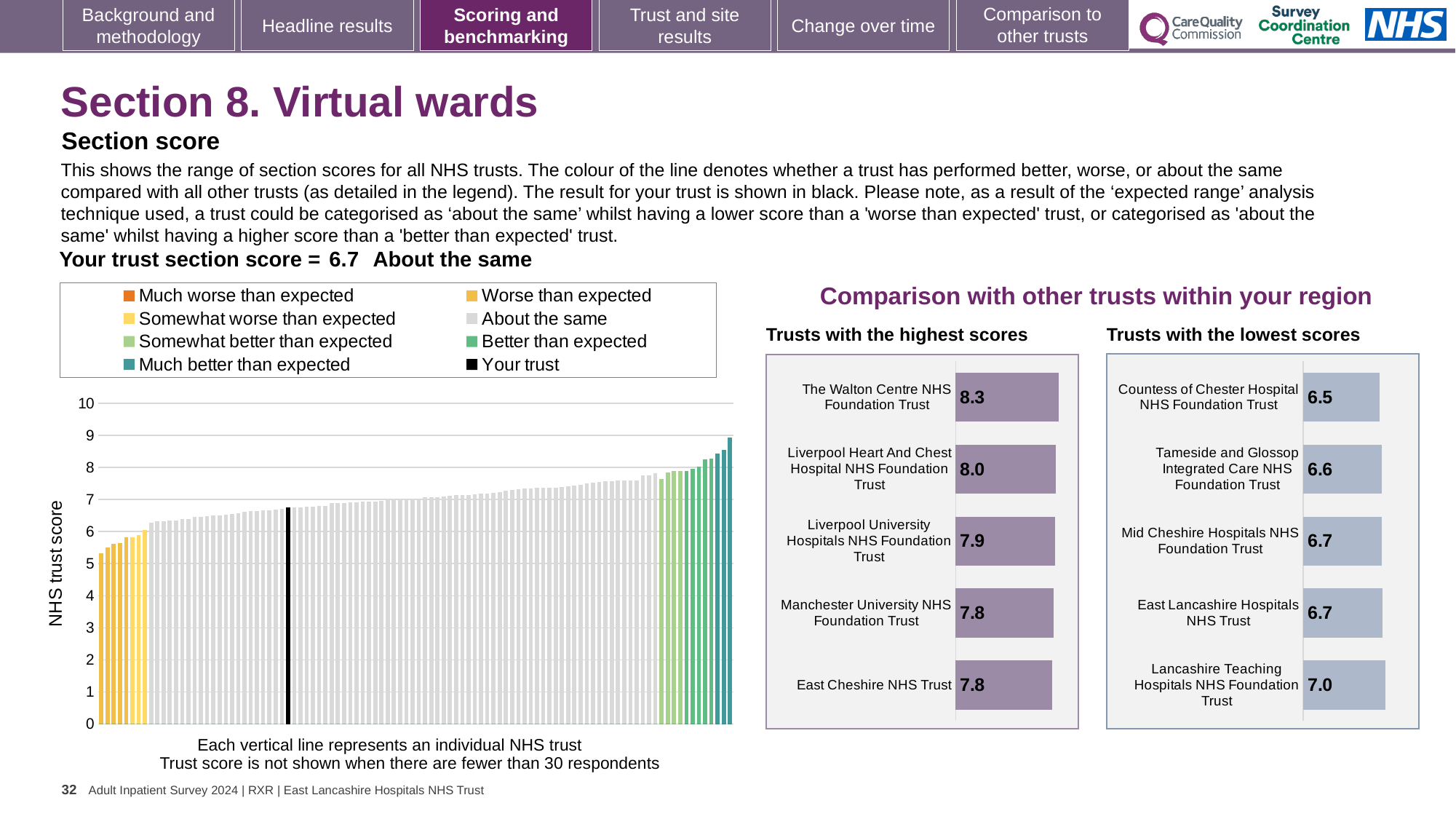
In the 'Trusts with the lowest scores' chart, which trust has the highest score? Lancashire Teaching Hospitals NHS Foundation Trust In the 'Trusts with the highest scores' chart, what is the score for The Walton Centre NHS Foundation Trust? 8.3 In the large chart on the left, is the value of the lowest bar greater or less than 5? greater In the 'Trusts with the highest scores' chart, what is the difference between The Walton Centre NHS Foundation Trust and Liverpool Heart And Chest Hospital NHS Foundation Trust? 0.3 What type of chart is the large chart on the left showing NHS trust scores? bar chart In the 'Trusts with the highest scores' chart, how many trusts are shown? 5 In the large chart on the left, what is the section score for your trust (the black bar)? 6.7 In the large chart on the left, what is the label on the vertical axis? NHS trust score In the 'Trusts with the lowest scores' chart, which trust has the lowest score? Countess of Chester Hospital NHS Foundation Trust In the large chart on the left, how many entries does the legend list? 8 In the large chart on the left, do the bar values rise or fall from left to right? rise In the 'Trusts with the lowest scores' chart, which is larger: the score for Tameside and Glossop Integrated Care NHS Foundation Trust or East Lancashire Hospitals NHS Trust? East Lancashire Hospitals NHS Trust